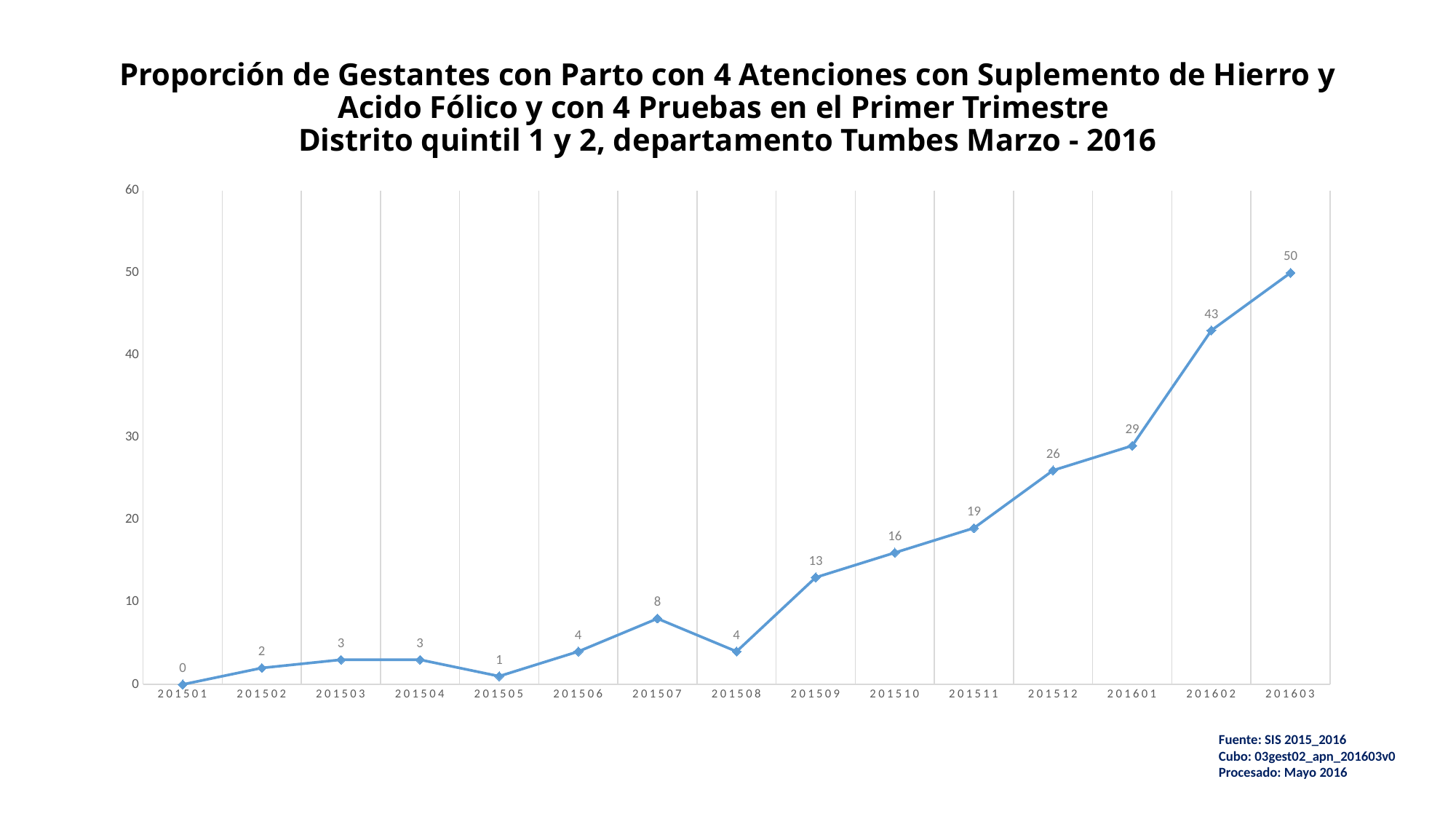
What kind of chart is shown? line chart Which is larger, the value for 201508 or the value for 201509? 201509 What is the value for 201603? 50 What is the maximum value shown on the y axis? 60 What is the value for 201512? 26 How many periods are plotted on the x axis? 15 What is the difference between the values for 201603 and 201602? 7 What is the value for 201507? 8 Which period has the highest value? 201603 Is the value for 201601 greater or less than 20? greater Do the values generally rise or fall from 201501 to 201603? rise Which period has the lowest value? 201501